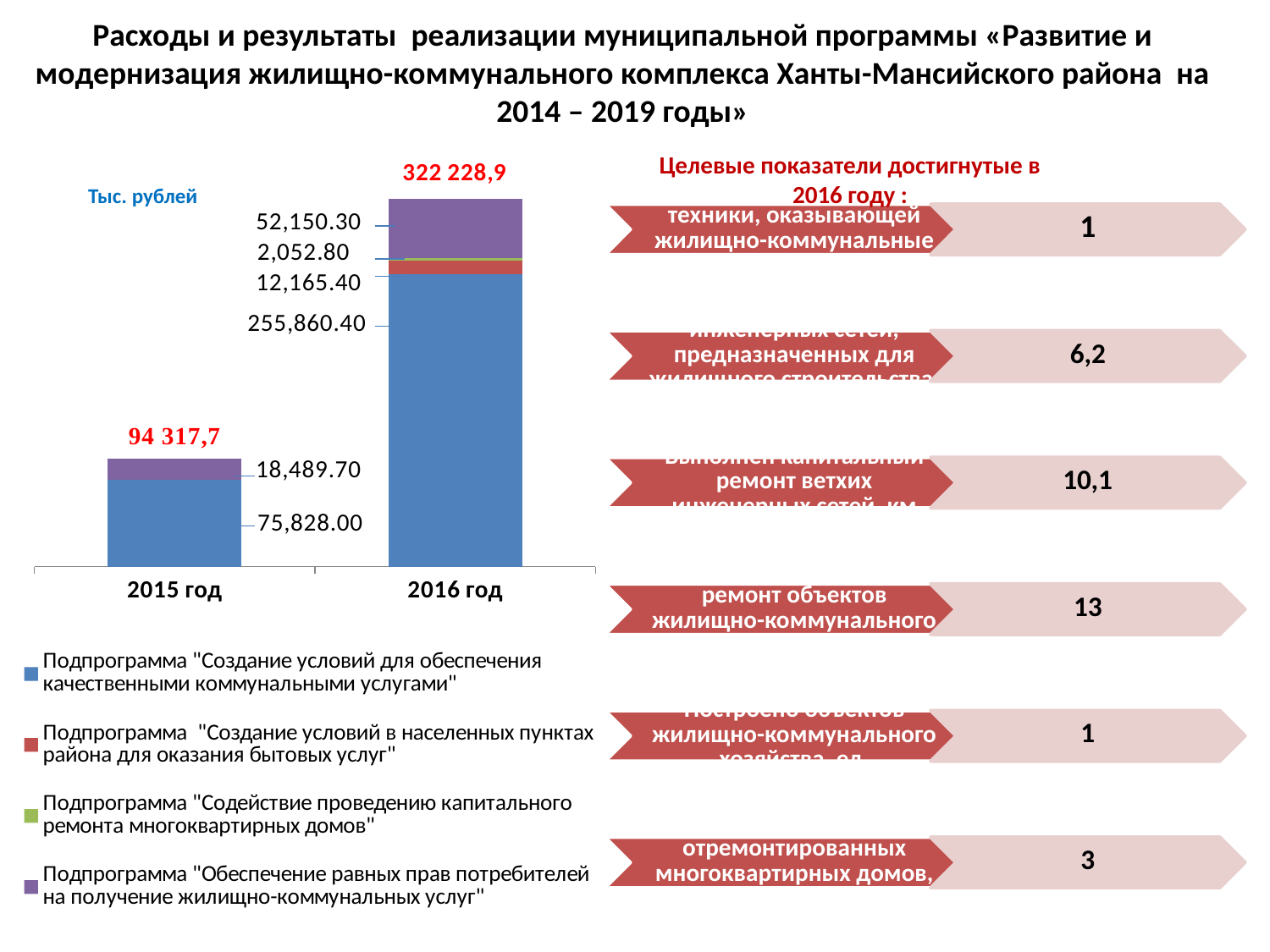
What is the value for the subprogram "Содействие проведению капитального ремонта многоквартирных домов" in 2016 год? 2,052.80 What is the value for the subprogram "Создание условий для обеспечения качественными коммунальными услугами" in 2016 год? 255,860.40 What is the value for the subprogram "Обеспечение равных прав потребителей на получение жилищно-коммунальных услуг" in 2016 год? 52,150.30 Which segment is the largest in the 2016 год bar? Подпрограмма "Создание условий для обеспечения качественными коммунальными услугами" How many series does the legend of the bar chart list? 4 What unit is indicated above the bar chart? Тыс. рублей How many year categories are shown on the x axis of the bar chart? 2 What is the total of the stacked bar for 2015 год? 94 317,7 What is the total of the stacked bar for 2016 год? 322 228,9 What is the value for the subprogram "Создание условий для обеспечения качественными коммунальными услугами" in 2015 год? 75,828.00 What kind of chart is shown on the left of the slide? stacked bar chart Which year has the higher total in the bar chart, 2015 год or 2016 год? 2016 год